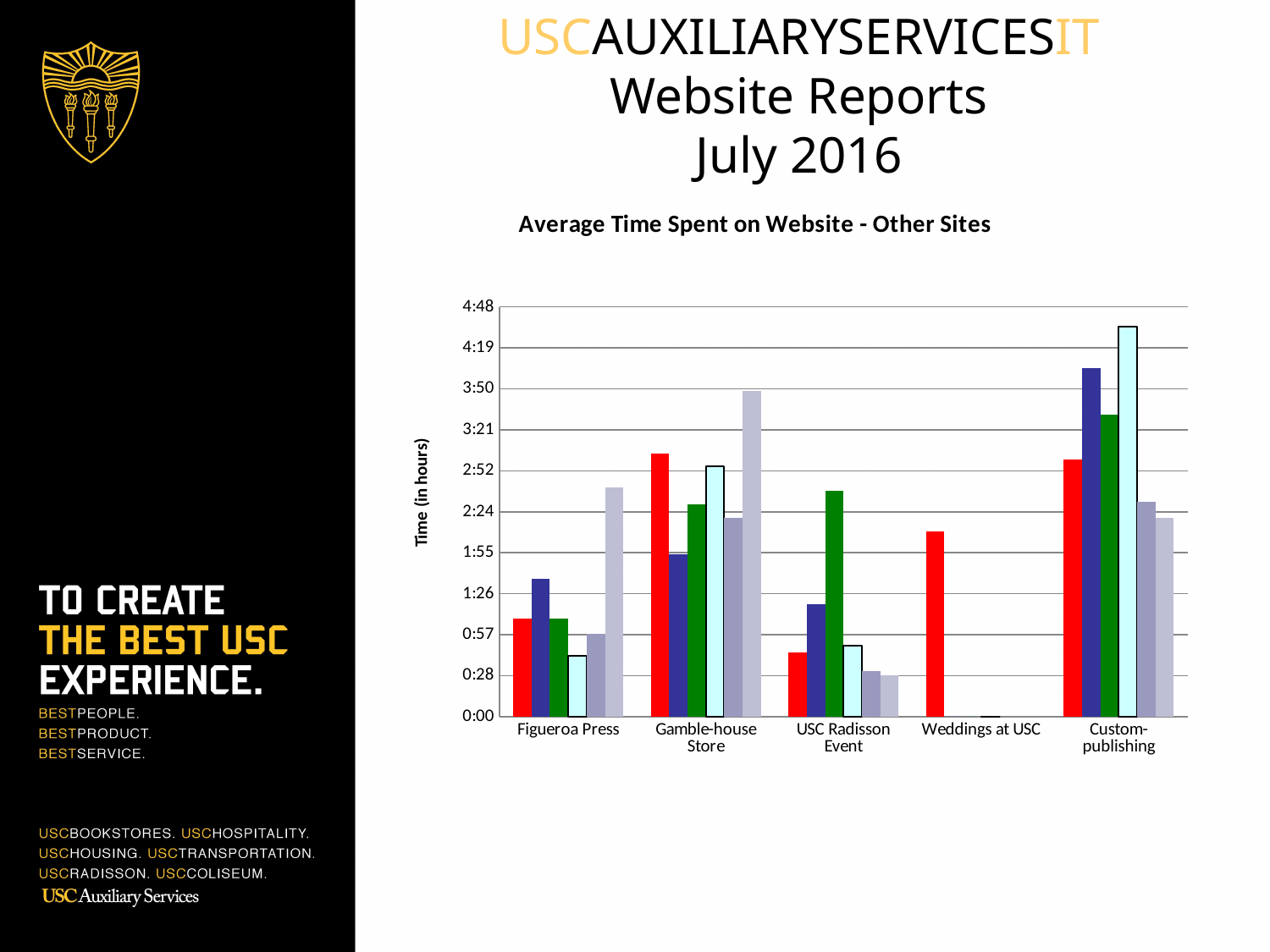
Is the value of the red bar for Weddings at USC greater or less than 1:55? greater What kind of chart is shown on the slide? bar chart Is the value of the light cyan bar for Custom-publishing greater or less than 4:19? greater Is the value of the red bar for USC Radisson Event greater or less than 0:57? less What is the label on the vertical axis of the chart? Time (in hours) What is the title of the chart? Average Time Spent on Website - Other Sites Which is larger, the red bar for Figueroa Press or the red bar for Gamble-house Store? Gamble-house Store How many categories are shown on the x axis of the chart? 5 Which category contains the tallest bar in the chart? Custom-publishing Which category has the tallest green bar? Custom-publishing